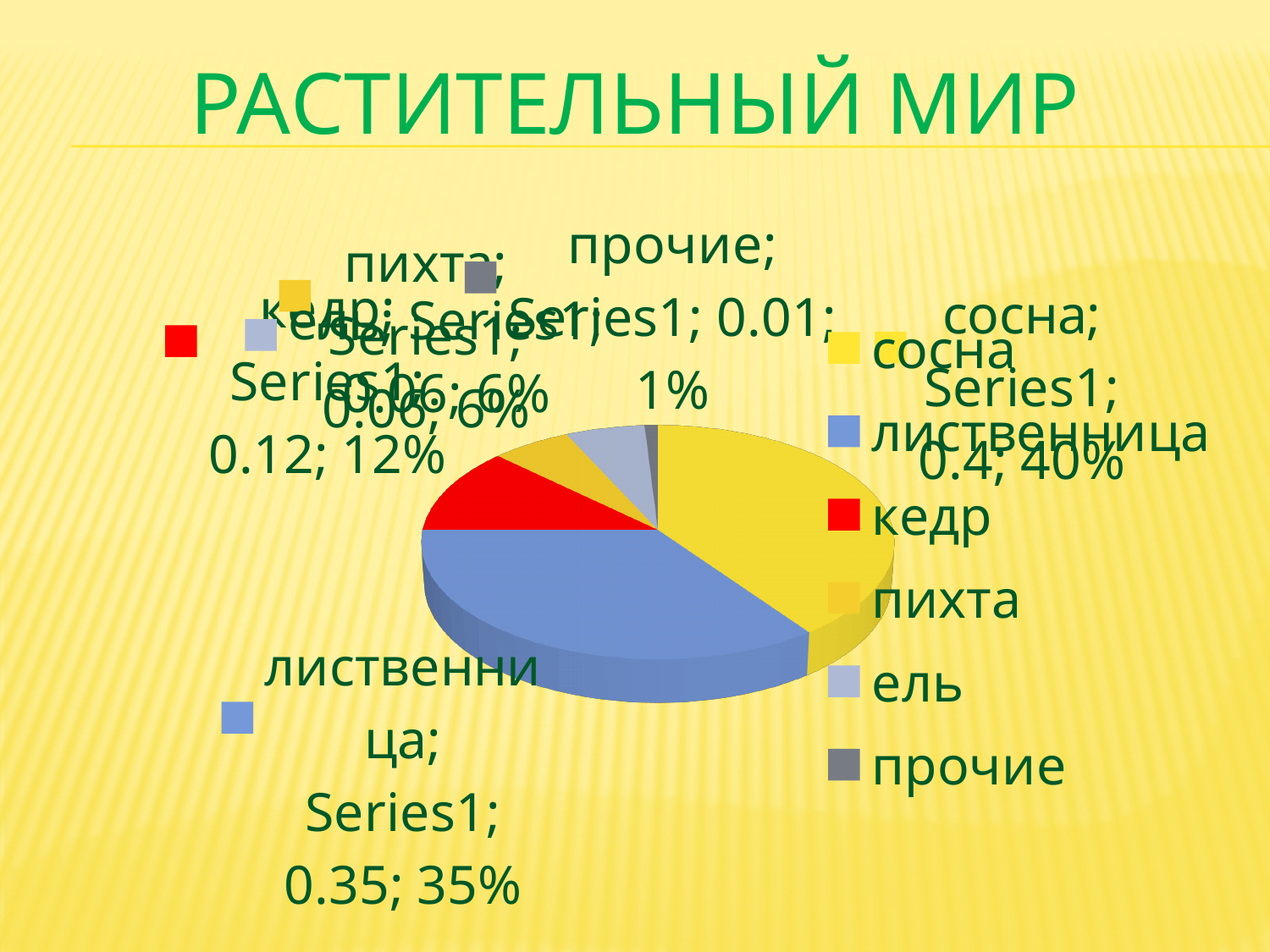
What percentage share does сосна have in the pie chart? 40% What kind of chart is shown on the slide? pie chart How many categories does the legend of the pie chart list? 6 What colour is the slice for кедр in the pie chart? red What percentage share does прочие have in the pie chart? 1% What percentage share does кедр have in the pie chart? 12% What is the difference in percentage points between the shares of сосна and лиственница? 5 What percentage share does лиственница have in the pie chart? 35% Which category has the largest slice of the pie chart? сосна Which has a larger share of the pie chart, кедр or лиственница? лиственница Which category has the smallest slice of the pie chart? прочие What is the title of the slide containing the pie chart? РАСТИТЕЛЬНЫЙ МИР